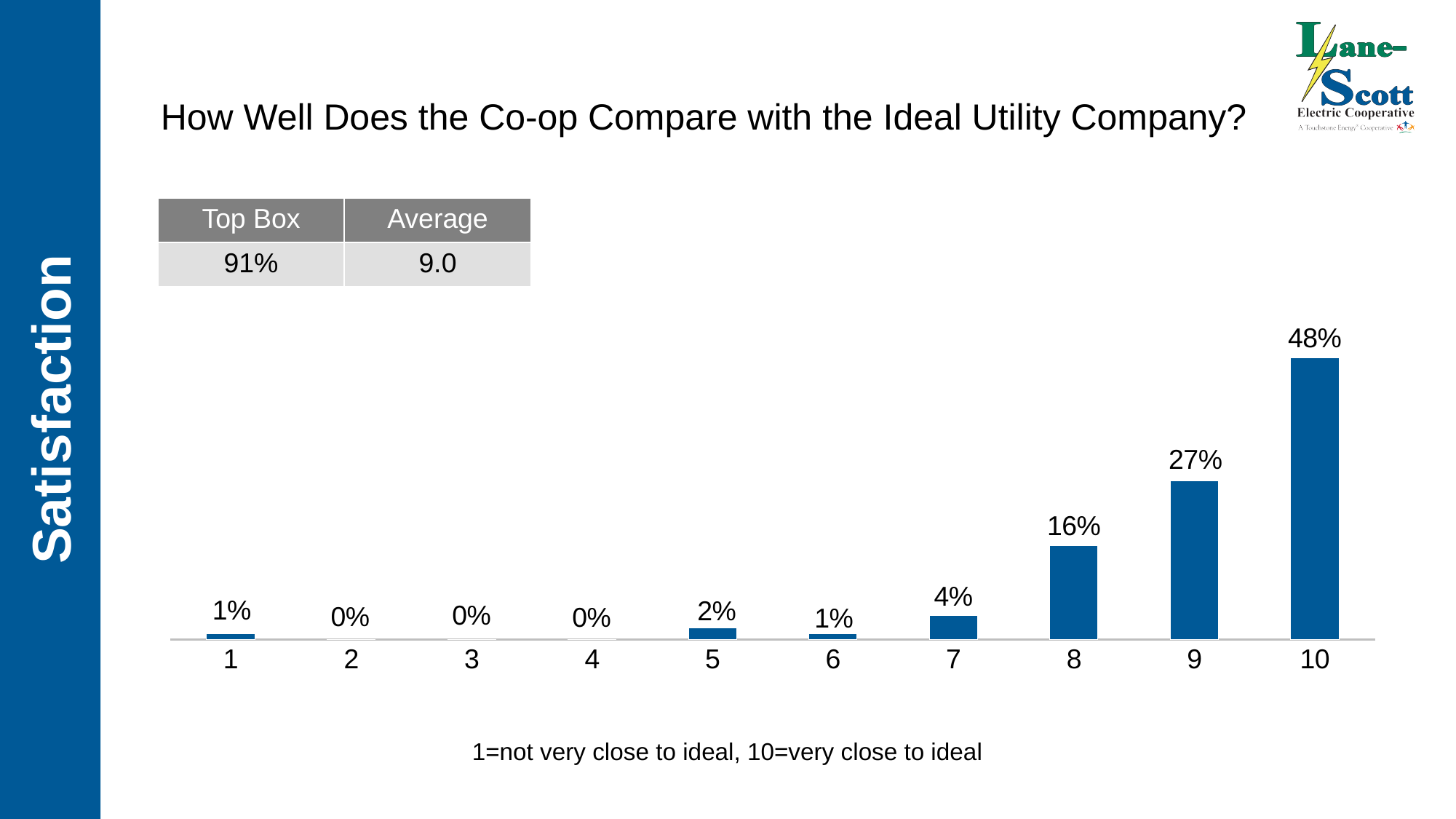
What percentage of respondents gave a rating of 8? 16% What is the difference in percentage points between ratings 10 and 9? 21 How many rating categories are shown on the x axis? 10 Which rating has the highest percentage of respondents? 10 What kind of chart is shown on the slide? bar chart Which has a larger percentage, rating 5 or rating 7? 7 What is the difference in percentage points between ratings 9 and 8? 11 What percentage of respondents gave a rating of 7? 4% What is the Average value shown in the table? 9.0 What percentage of respondents gave a rating of 10? 48% What is the Top Box value shown in the table? 91% Do the percentages generally rise or fall as the rating increases from 7 to 10? rise